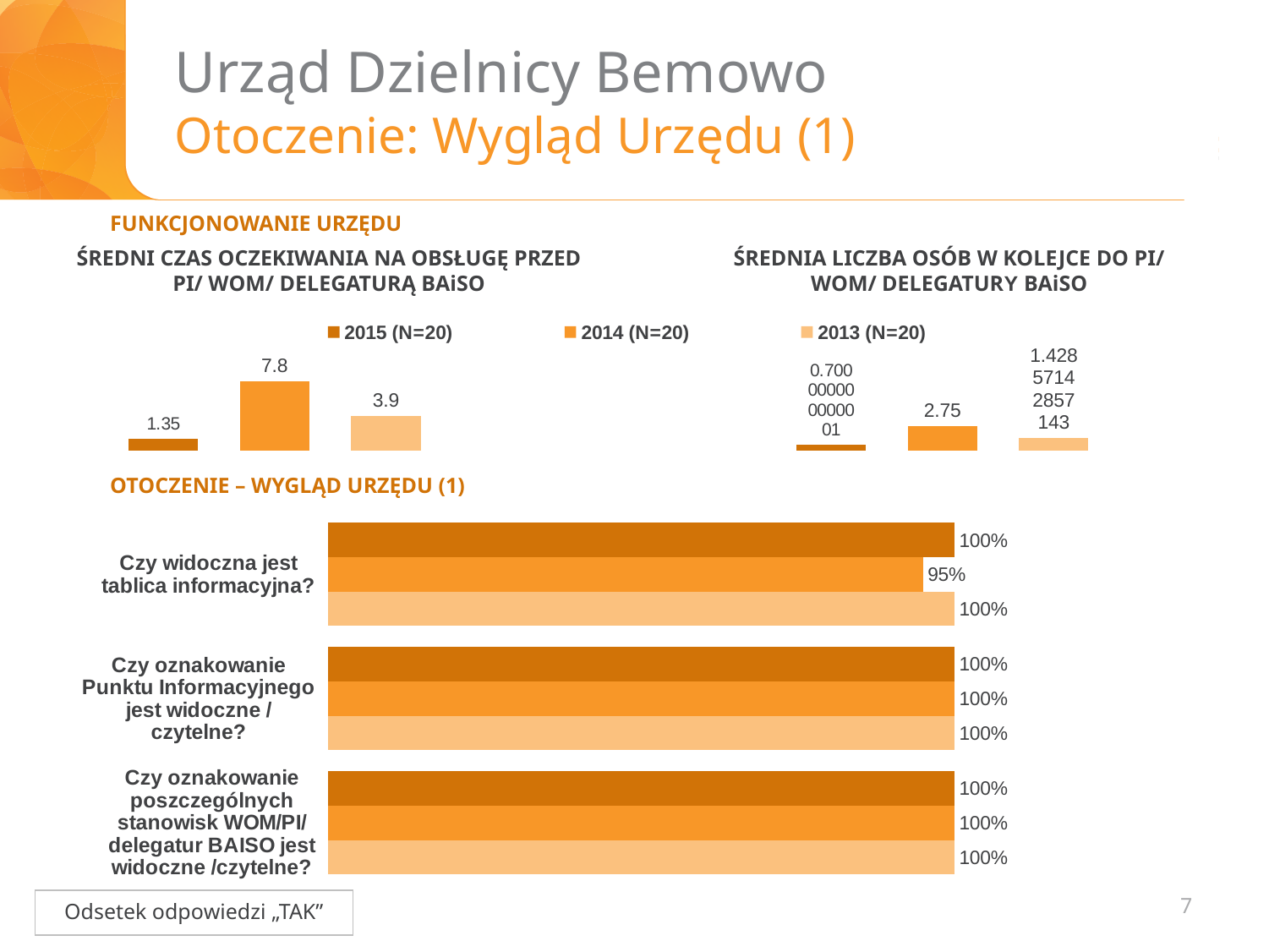
In the bottom chart 'OTOCZENIE – WYGLĄD URZĘDU (1)', what is the 2015 value for 'Czy oznakowanie Punktu Informacyjnego jest widoczne / czytelne?'? 100% In the chart 'ŚREDNI CZAS OCZEKIWANIA NA OBSŁUGĘ PRZED PI/ WOM/ DELEGATURĄ BAiSO', what is the value for 2014 (N=20)? 7.8 How many question categories are shown in the bottom chart 'OTOCZENIE – WYGLĄD URZĘDU (1)'? 3 In the chart 'ŚREDNI CZAS OCZEKIWANIA NA OBSŁUGĘ PRZED PI/ WOM/ DELEGATURĄ BAiSO', which year has the highest value? 2014 (N=20) How many series does the legend list for the charts on this slide? 3 In the chart 'ŚREDNI CZAS OCZEKIWANIA NA OBSŁUGĘ PRZED PI/ WOM/ DELEGATURĄ BAiSO', what is the value for 2015 (N=20)? 1.35 In the bottom chart 'OTOCZENIE – WYGLĄD URZĘDU (1)', what is the 2014 value for 'Czy widoczna jest tablica informacyjna?'? 95% In the chart 'ŚREDNI CZAS OCZEKIWANIA NA OBSŁUGĘ PRZED PI/ WOM/ DELEGATURĄ BAiSO', what is the difference between the 2014 and 2013 values? 3.9 In the chart 'ŚREDNIA LICZBA OSÓB W KOLEJCE DO PI/ WOM/ DELEGATURY BAiSO', which is larger: the value for 2014 or the value for 2013? 2014 In the chart 'ŚREDNI CZAS OCZEKIWANIA NA OBSŁUGĘ PRZED PI/ WOM/ DELEGATURĄ BAiSO', which year has the lowest value? 2015 (N=20) In the chart 'ŚREDNIA LICZBA OSÓB W KOLEJCE DO PI/ WOM/ DELEGATURY BAiSO', what is the value for 2014 (N=20)? 2.75 In the chart 'ŚREDNIA LICZBA OSÓB W KOLEJCE DO PI/ WOM/ DELEGATURY BAiSO', which year has the highest value? 2014 (N=20)